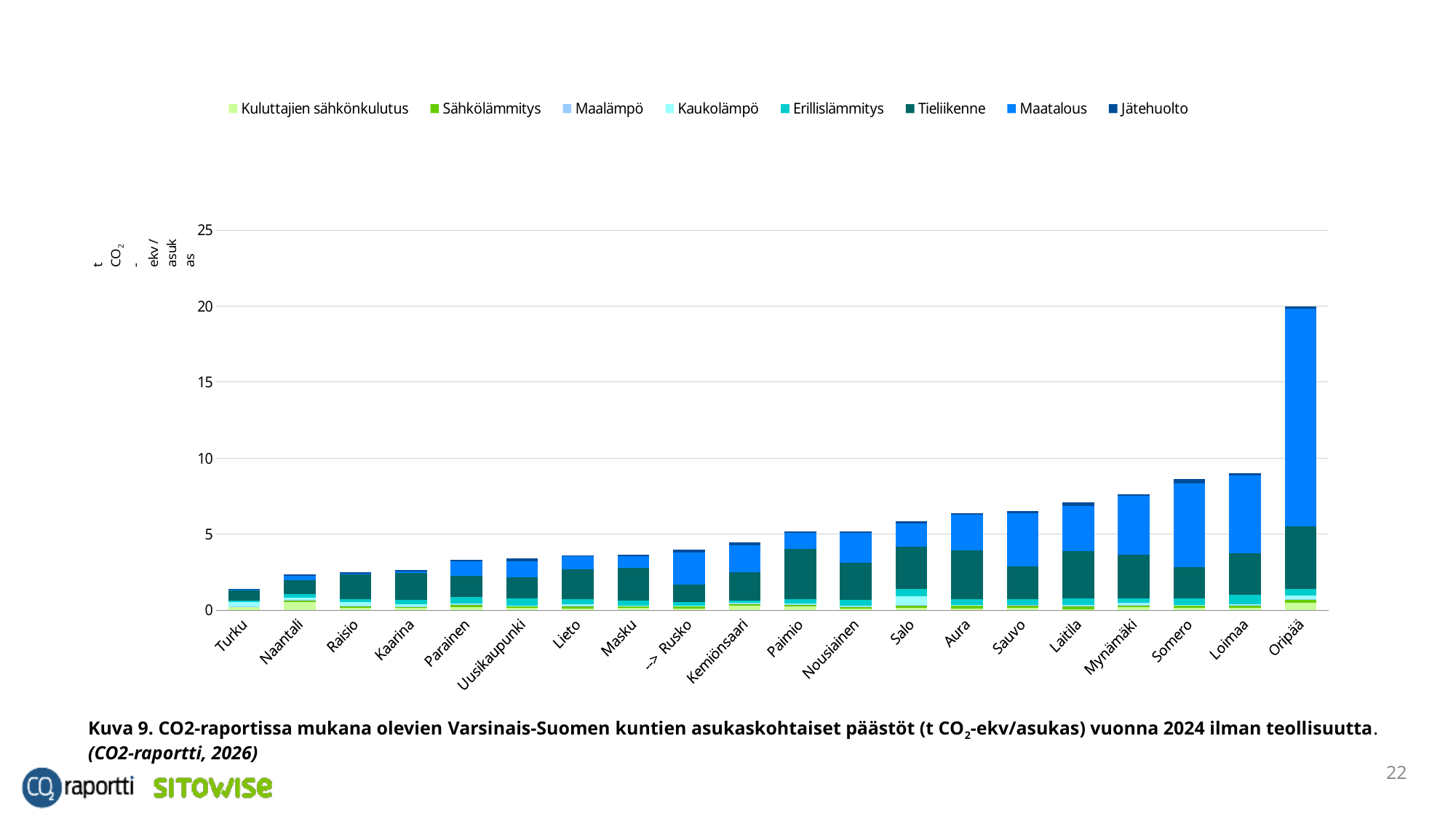
How many series does the legend list? 8 Which municipality has the lowest total emissions per inhabitant? Turku Is the total value for Loimaa greater or less than 5? greater Is the total value for Oripää greater or less than 15? greater Which series makes up the largest part of the Oripää bar? Maatalous Is the total value for Turku greater or less than 5? less What is the last series listed in the legend? Jätehuolto How many municipalities are shown on the x axis? 20 Do the total bar heights generally rise or fall from left to right along the x axis? Rise What kind of chart is shown on the slide? Stacked bar chart Which has a larger total, Naantali or Turku? Naantali Which municipality has the highest total emissions per inhabitant? Oripää